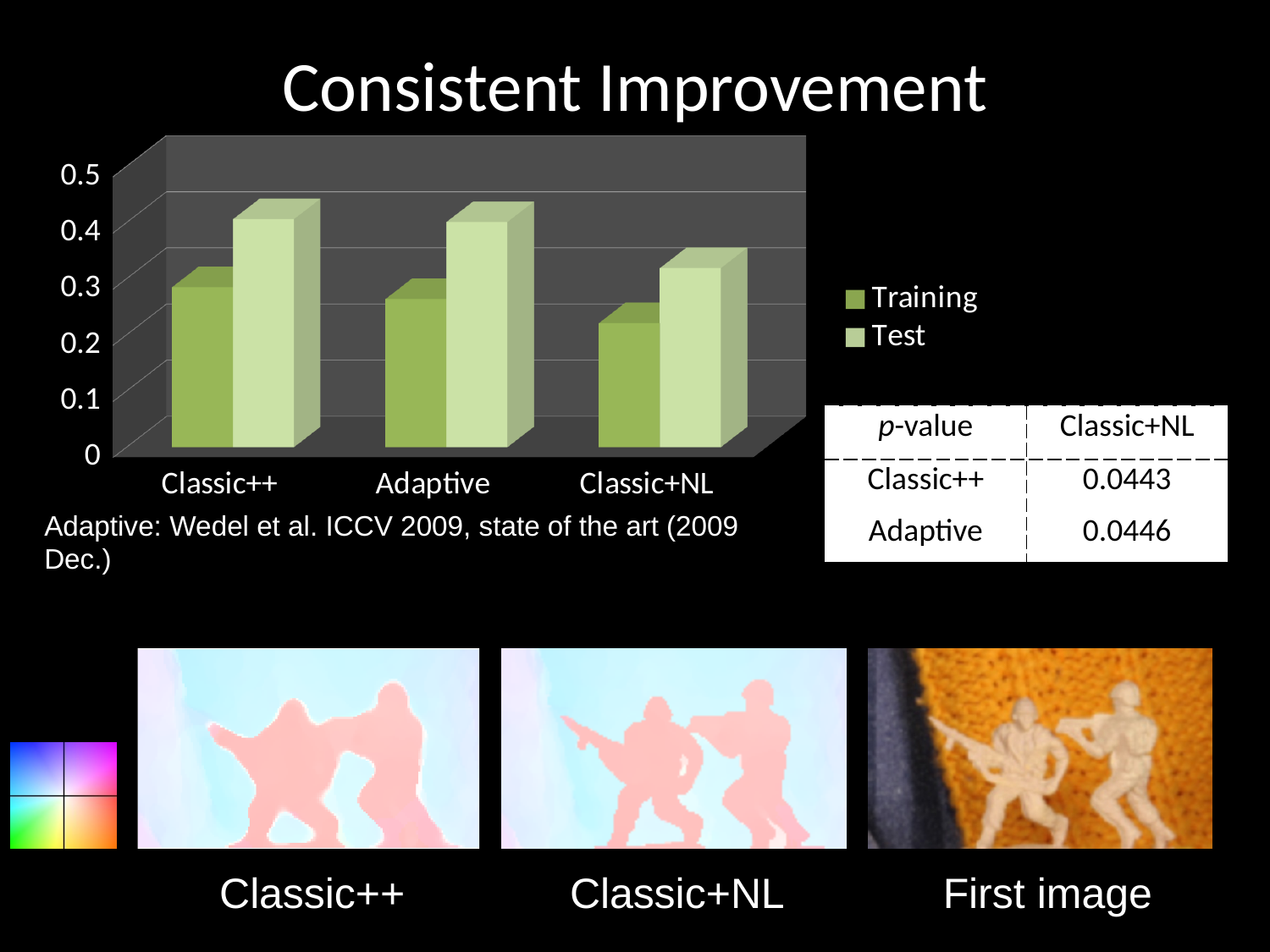
Which is larger, the Test value for Classic++ or the Test value for Classic+NL? Classic++ Which category has the lowest Training value? Classic+NL What is the title of the slide containing the chart? Consistent Improvement Which category has the lowest Test value? Classic+NL Is the Test value for Classic++ greater or less than 0.3? greater What are the two series named in the chart legend? Training and Test Is the Test value for Classic+NL greater or less than 0.4? less What kind of chart is shown on the slide? bar chart How many series does the chart legend list? 2 Is the Training value for Classic+NL greater or less than 0.3? less For Classic++, which series has the larger value, Training or Test? Test How many categories are shown on the x axis of the chart? 3